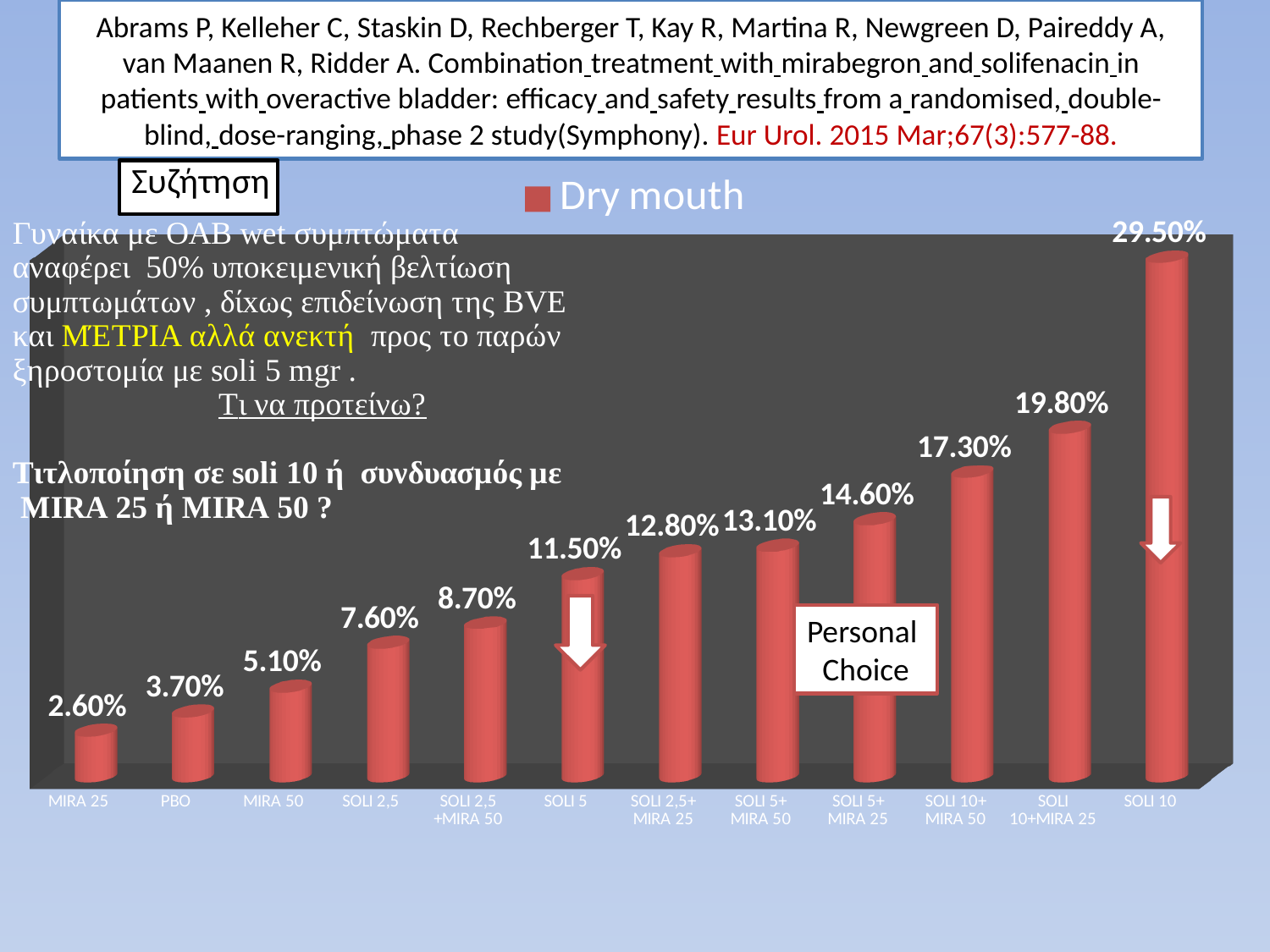
How many series does the chart legend list? 1 What is the difference in dry mouth rate between SOLI 10 and SOLI 5? 18.00% What is the difference in dry mouth rate between SOLI 10+MIRA 25 and SOLI 10+MIRA 50? 2.50% Which category has the lowest dry mouth rate? MIRA 25 How many categories are shown on the x axis of the chart? 12 What is the dry mouth rate for SOLI 10? 29.50% What kind of chart is shown on the slide? Bar chart Which category has the highest dry mouth rate? SOLI 10 What is the dry mouth rate for SOLI 10+MIRA 25? 19.80% What is the dry mouth rate for SOLI 5? 11.50% What is the dry mouth rate for PBO? 3.70% Which has a higher dry mouth rate, MIRA 50 or SOLI 2,5? SOLI 2,5